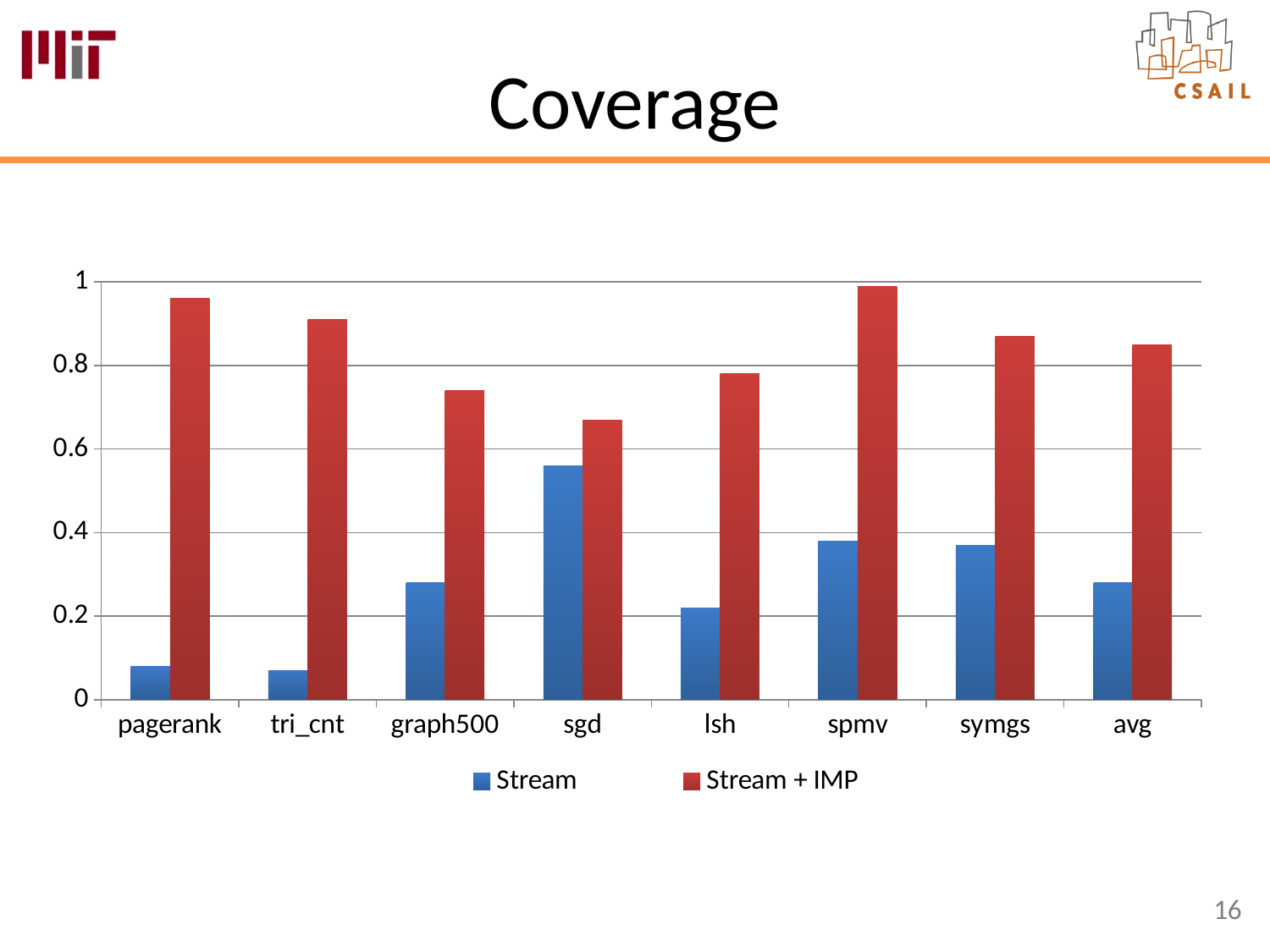
Which category has the highest Stream value? sgd Is the Stream + IMP value for pagerank greater or less than 0.8? greater Which is larger, the Stream value for spmv or for graph500? spmv Is the Stream + IMP value for graph500 greater or less than 0.8? less Is the Stream value for sgd greater or less than 0.4? greater Which category has the lowest Stream + IMP value? sgd How many series does the legend list? 2 How many categories are shown on the x axis? 8 What kind of chart is shown on the slide? bar chart What is the title of the slide containing the chart? Coverage Which is larger, the Stream + IMP value for lsh or for sgd? lsh